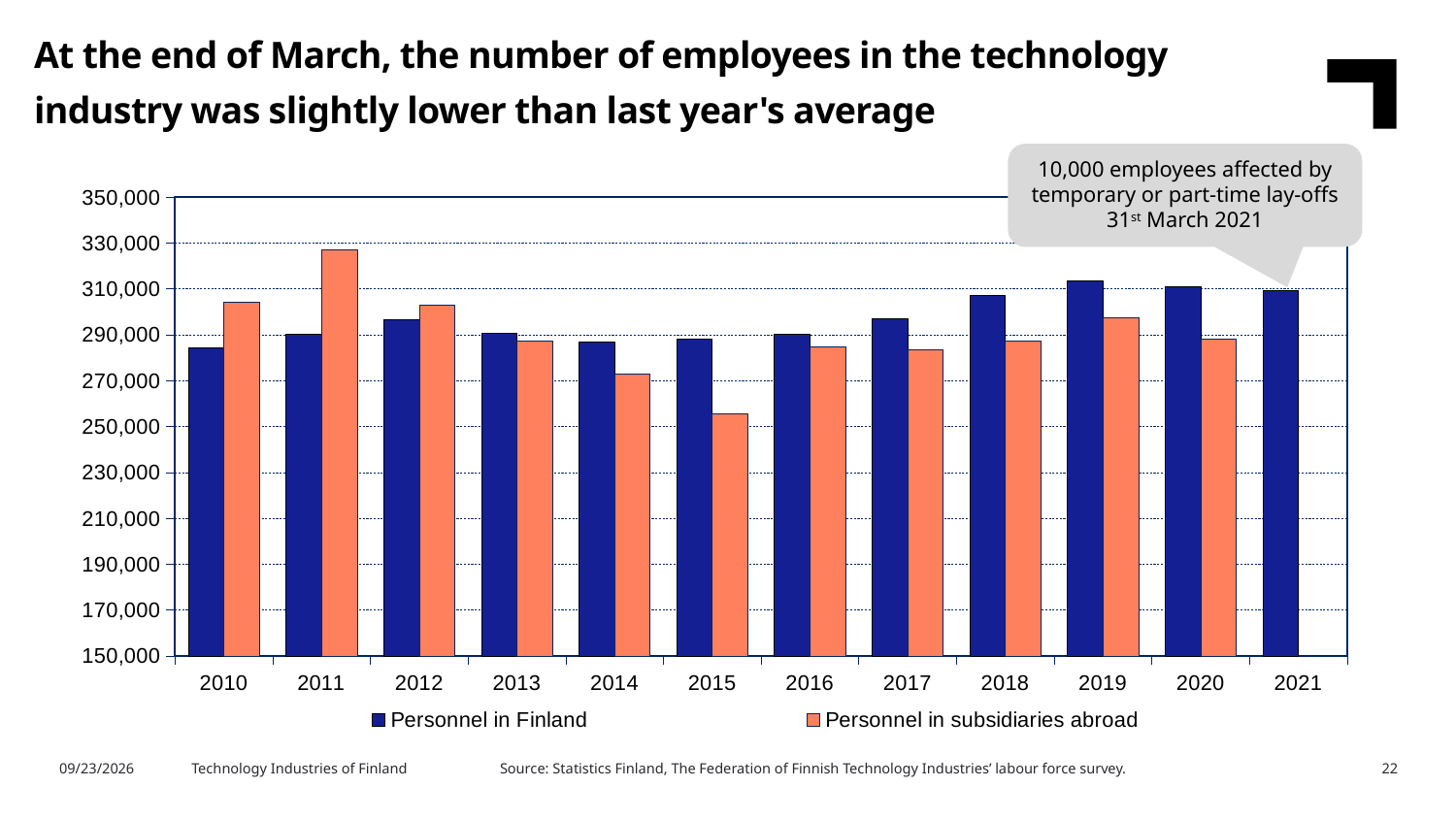
Is the value for Personnel in Finland in 2018 greater or less than 290,000? greater Which year on the x axis has only a Personnel in Finland bar and no Personnel in subsidiaries abroad bar? 2021 In 2015, which is larger: Personnel in Finland or Personnel in subsidiaries abroad? Personnel in Finland In which year is Personnel in subsidiaries abroad highest? 2011 Is the value for Personnel in subsidiaries abroad in 2011 greater or less than 310,000? greater In which year is Personnel in subsidiaries abroad lowest? 2015 Does Personnel in Finland rise or fall from 2015 to 2019? Rise In 2011, which is larger: Personnel in Finland or Personnel in subsidiaries abroad? Personnel in subsidiaries abroad How many years are shown on the x axis? 12 How many series does the legend list? 2 What kind of chart is shown on the slide? Bar chart Is the value for Personnel in subsidiaries abroad in 2015 greater or less than 270,000? less